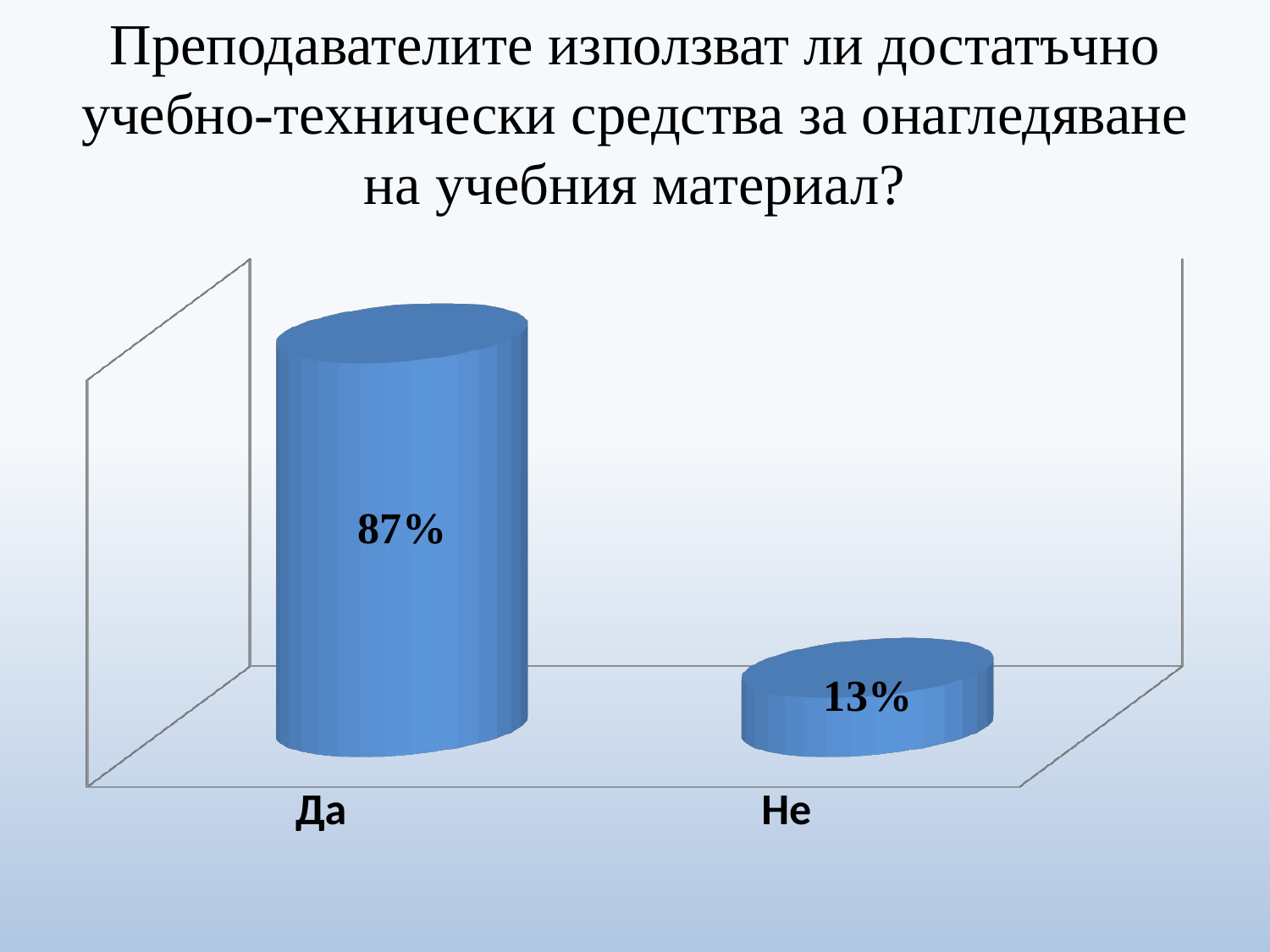
What is the value for "Да"? 87% What kind of chart is shown on the slide? Bar chart What is the value for "Не"? 13% Which category has the lowest value? Не How many categories are shown on the chart? 2 What is the difference between the values for "Да" and "Не"? 74% What colour are the bars on the chart? Blue What question does the slide title ask (in Bulgarian)? Преподавателите използват ли достатъчно учебно-технически средства за онагледяване на учебния материал? What is the total of the two values shown on the chart? 100% Which category has the highest value? Да Which is larger, the value for "Да" or the value for "Не"? Да